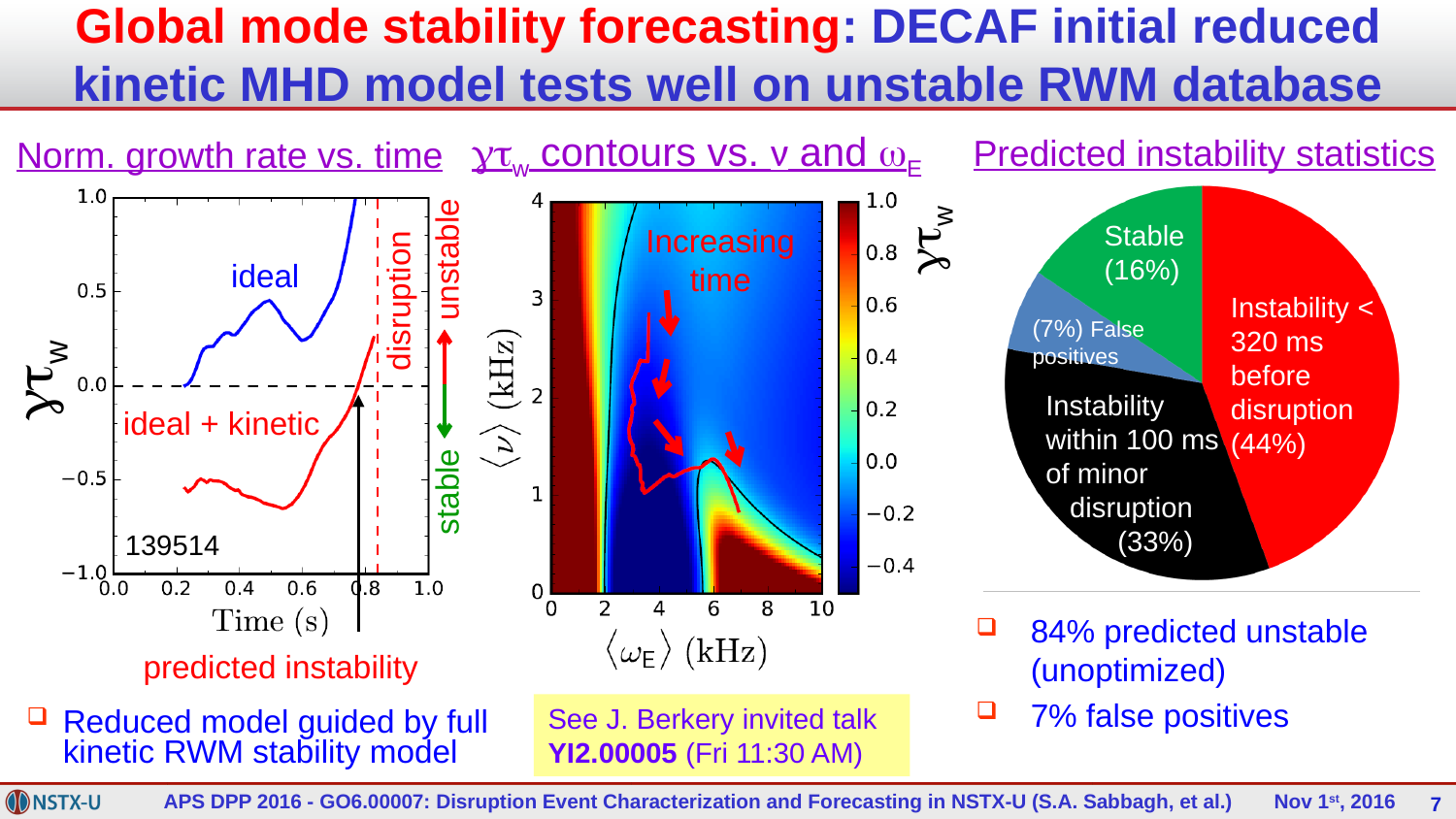
In the 'Predicted instability statistics' pie chart, what is the difference between the 'Instability < 320 ms before disruption' share and the 'Stable' share? 28% In the 'Norm. growth rate vs. time' chart on the left, how many curves are plotted? 2 In the 'Predicted instability statistics' pie chart, what colour is the 'Stable' slice? Green In the 'Predicted instability statistics' pie chart, what share is labelled 'Stable'? 16% In the 'Predicted instability statistics' pie chart, which slice is the smallest? False positives In the 'Predicted instability statistics' pie chart, which is larger: the 'Stable' slice or the 'Instability within 100 ms of minor disruption' slice? Instability within 100 ms of minor disruption What kind of chart is the 'Predicted instability statistics' chart on the right of the slide? Pie chart In the 'Predicted instability statistics' pie chart, what share is labelled 'Instability within 100 ms of minor disruption'? 33% In the 'Predicted instability statistics' pie chart, what share is labelled 'False positives'? 7% In the 'Predicted instability statistics' pie chart, which slice is the largest? Instability < 320 ms before disruption In the 'Predicted instability statistics' pie chart, what share is labelled 'Instability < 320 ms before disruption'? 44% In the 'Predicted instability statistics' pie chart, how many slices are there? 4